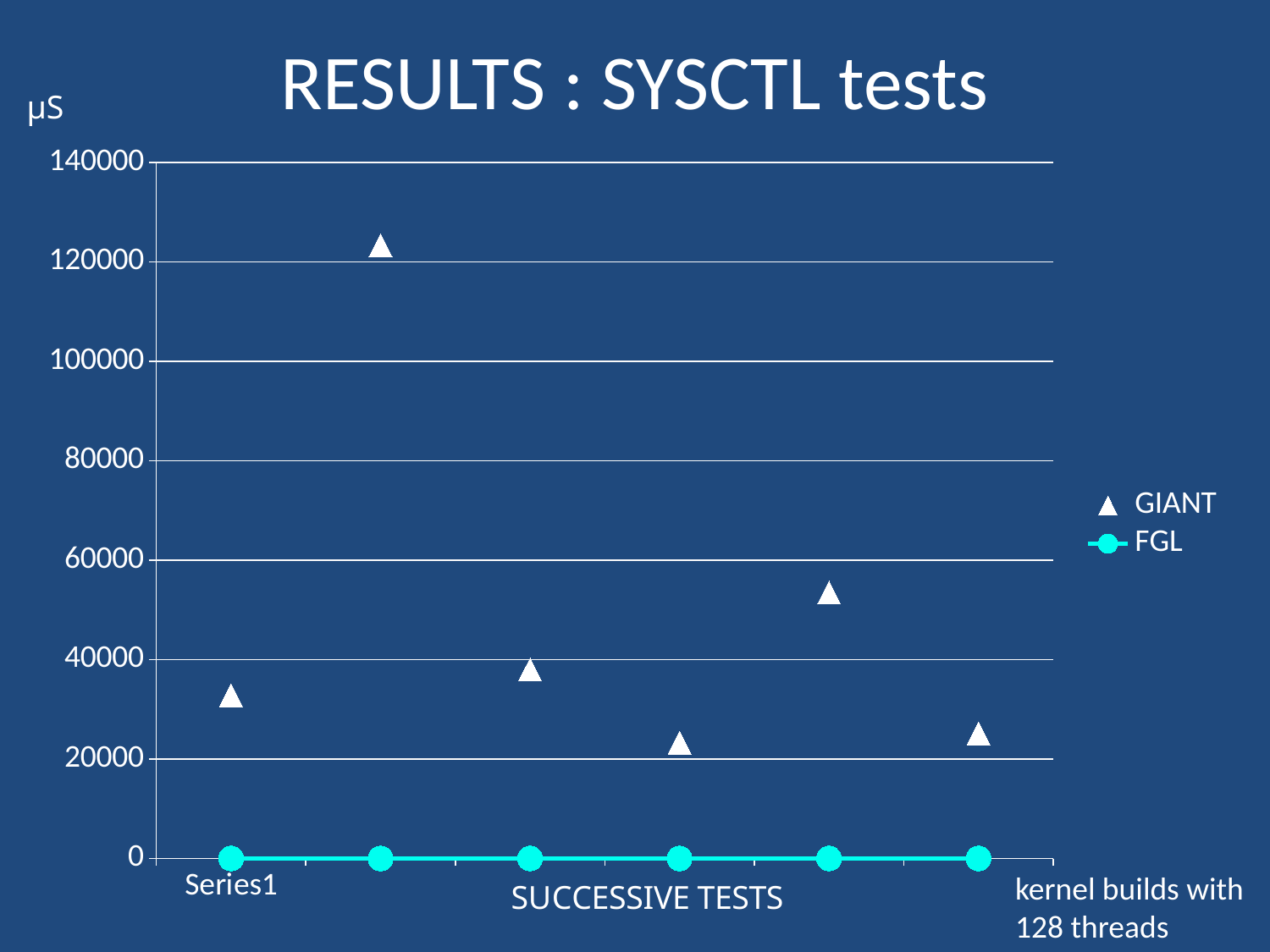
Is the value of the fifth GIANT point greater or less than 60000? less How many series does the legend list? 2 What is the title of the chart? RESULTS : SYSCTL tests Is the second GIANT point larger or smaller than the fifth GIANT point? larger Is the value of the second GIANT point greater or less than 100000? greater How many data points are plotted for the GIANT series? 6 What are the names of the two series in the legend? GIANT and FGL Which series has the higher values across the successive tests, GIANT or FGL? GIANT Which of the six tests has the highest GIANT value? the second test What kind of chart is shown on the slide? line chart Is the value of the first GIANT point greater or less than 20000? greater